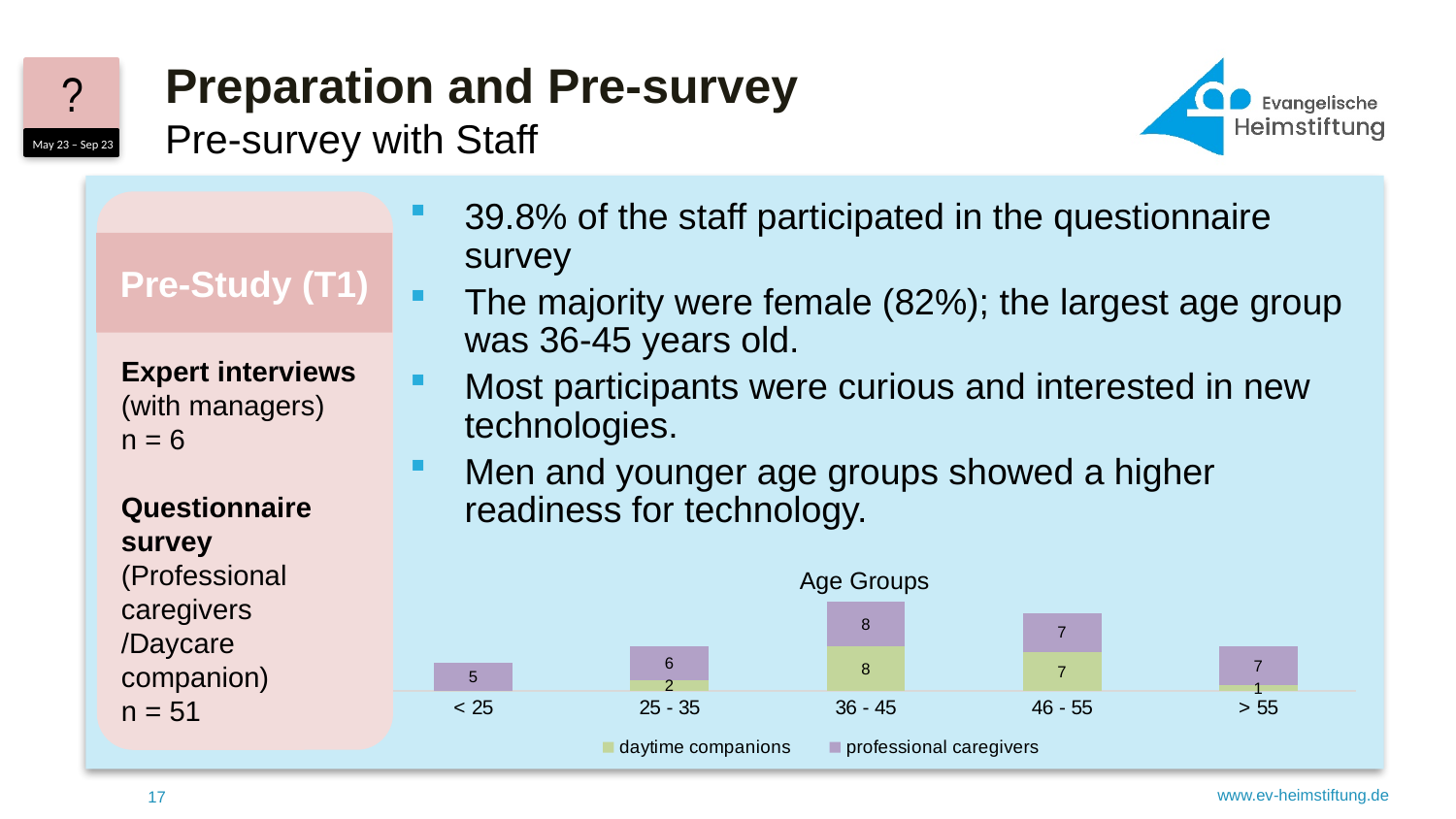
What is the difference between professional caregivers and daytime companions in the > 55 age group? 6 What is the value for daytime companions in the > 55 age group? 1 What is the value for professional caregivers in the 36 - 45 age group? 8 How many series does the chart legend list? 2 Which series is shown in purple in the chart? professional caregivers What is the total of the stacked bar for the 46 - 55 age group? 14 How many age group categories are shown on the x axis of the chart? 5 What is the value for daytime companions in the 25 - 35 age group? 2 Which age group has the highest total stacked bar? 36 - 45 What is the total of the stacked bar for the 36 - 45 age group? 16 What is the value for professional caregivers in the > 55 age group? 7 What type of chart is shown under the heading "Age Groups"? stacked bar chart